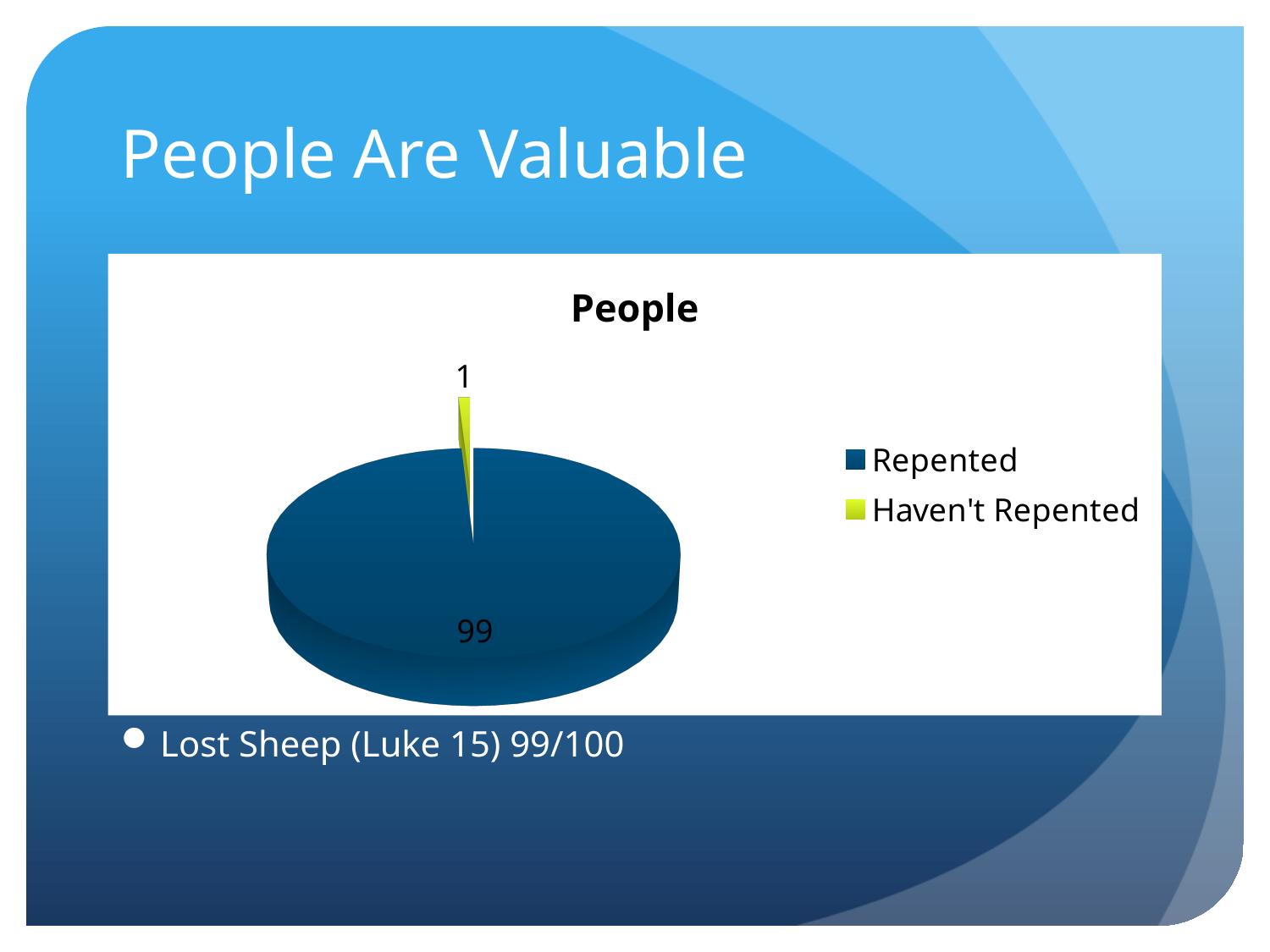
Which category has the largest slice of the pie? Repented What is the total of the two slices in the pie chart? 100 Which is larger, Repented or Haven't Repented? Repented What is the value for Repented? 99 What share of the pie does the Repented slice represent? 99% How many categories does the pie chart show? 2 What kind of chart is shown on the slide? Pie chart What is the value for Haven't Repented? 1 What colour is the Haven't Repented slice? Yellow-green What is the title of the chart? People Which category has the smallest slice of the pie? Haven't Repented What is the difference between the values for Repented and Haven't Repented? 98